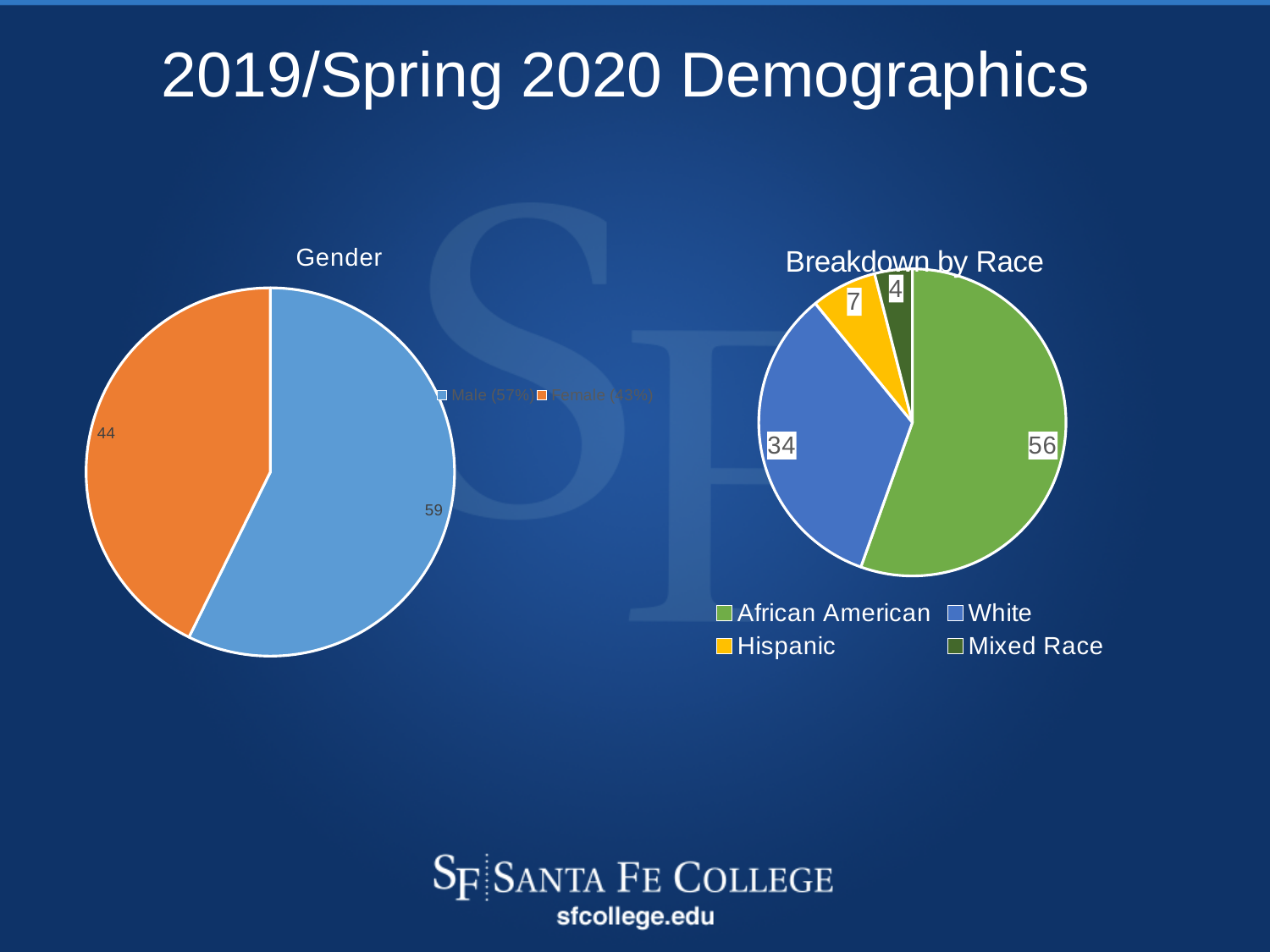
In the Breakdown by Race chart, what colour is the Hispanic slice? Yellow In the Breakdown by Race chart, which category has the largest slice? African American How many categories does the Breakdown by Race chart show? 4 In the Breakdown by Race chart, what is the value for Hispanic? 7 In the Breakdown by Race chart, which category has the smallest slice? Mixed Race In the Gender chart, which slice is larger, Male or Female? Male In the Gender chart, what is the value for Male? 59 In the Breakdown by Race chart, what is the value for White? 34 In the Gender chart, what is the difference between the Male and Female values? 15 In the Gender chart, what is the value for Female? 44 In the Breakdown by Race chart, what is the difference between the African American and White values? 22 What kind of chart is the Gender chart? Pie chart